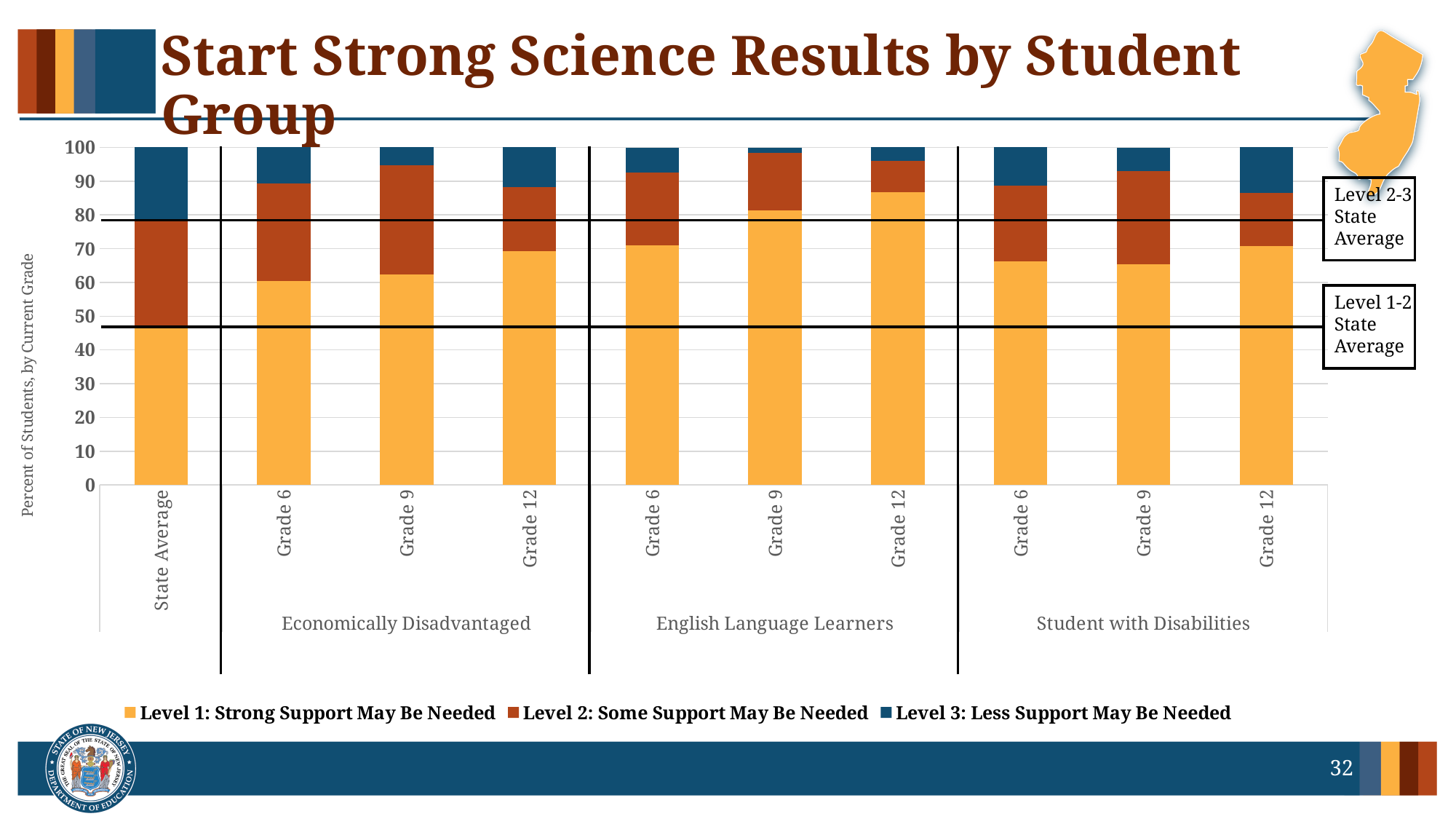
How many bars are plotted in the chart? 10 Is the Level 1 value for State Average greater or less than 50? less Which legend entry is shown in dark blue? Level 3: Less Support May Be Needed Is the Level 1 value for English Language Learners Grade 12 greater or less than 80? greater How many series does the legend list? 3 What kind of chart is shown on the slide? Stacked bar chart What is the title of the vertical axis? Percent of Students, by Current Grade How many student groups (excluding State Average) are shown along the x axis? 3 Which has a larger Level 1 segment: Economically Disadvantaged Grade 6 or English Language Learners Grade 6? English Language Learners Grade 6 Which bar has the largest Level 1: Strong Support May Be Needed segment? English Language Learners Grade 12 Is the Level 1 value for Economically Disadvantaged Grade 12 greater or less than 60? greater Which bar has the smallest Level 1: Strong Support May Be Needed segment? State Average